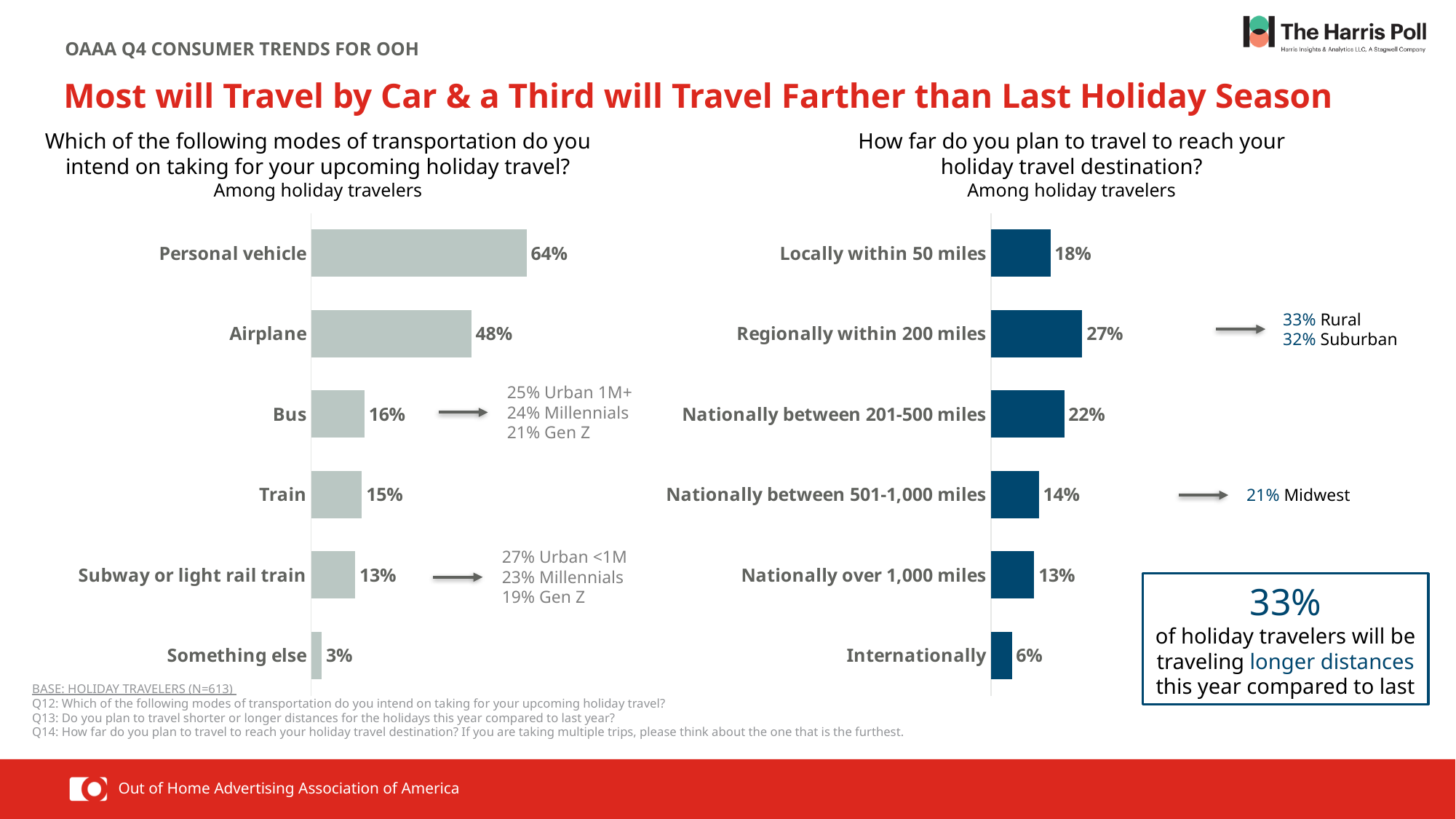
In the right chart on travel distance, which category has the highest value? Regionally within 200 miles In the left chart on modes of transportation, which is larger, Bus or Train? Bus In the right chart on travel distance, which category has the lowest value? Internationally In the right chart on travel distance, what percentage plan to travel regionally within 200 miles? 27% In the left chart on modes of transportation, what is the difference between the Personal vehicle and Airplane values? 16 percentage points In the right chart on travel distance, what is the value for Nationally between 501-1,000 miles? 14% In the left chart on modes of transportation, what percentage of holiday travelers intend to take a personal vehicle? 64% In the left chart on modes of transportation, what is the value for Airplane? 48% In the right chart on travel distance, what is the difference between Locally within 50 miles and Internationally? 12 percentage points In the left chart on modes of transportation, which mode has the lowest value? Something else What type of chart is used on the right side of the slide for travel distance? Bar chart How many modes of transportation are listed in the left chart? 6